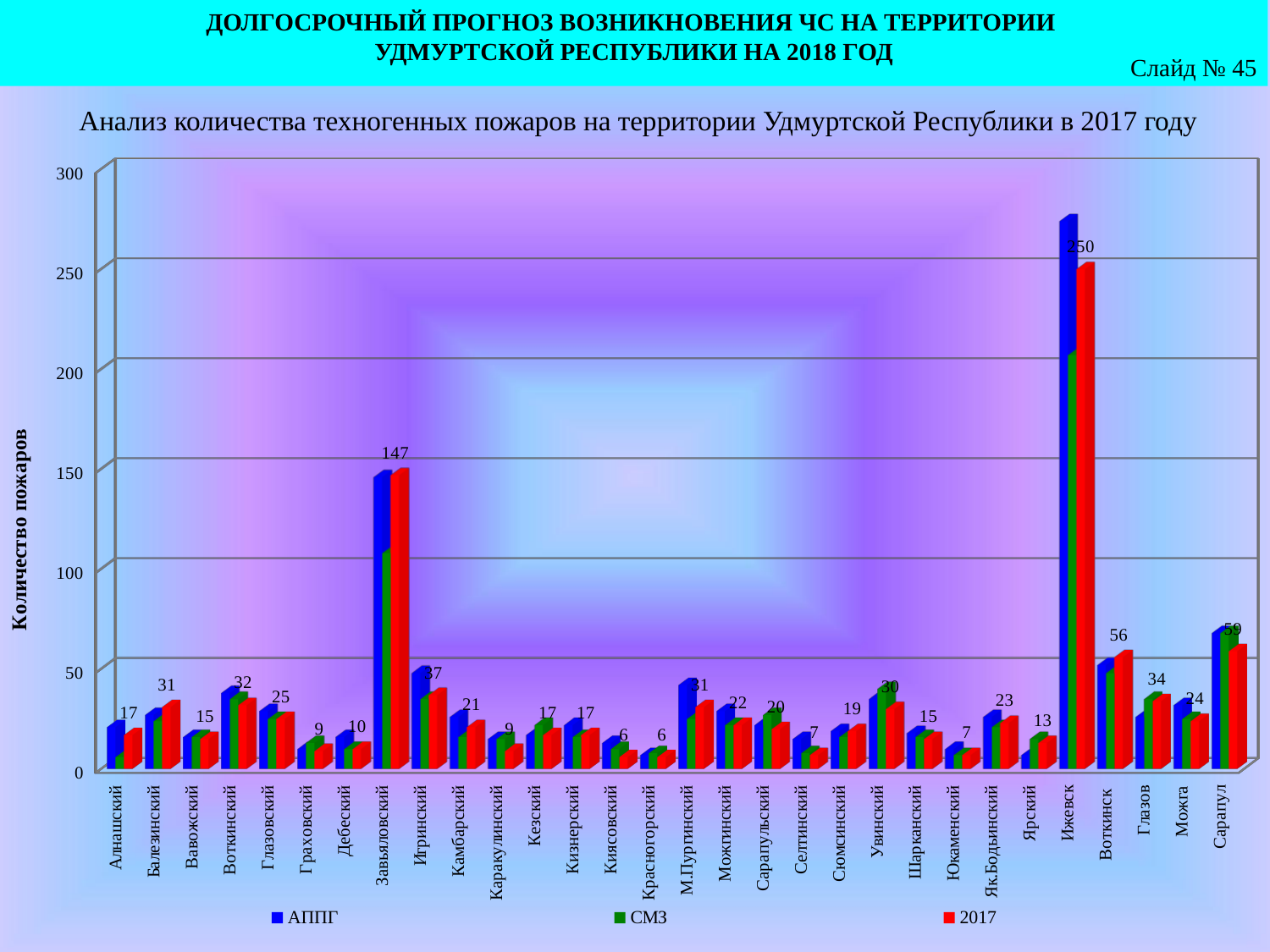
Which has the larger 2017 value, Сарапул or Воткинск? Сарапул How many categories are shown on the x axis? 30 Is the АППГ value for Ижевск greater or less than 250? greater What is the value of the 2017 series for Ижевск? 250 What is the value of the 2017 series for Игринский? 37 What is the difference between the 2017 values for Ижевск and Завьяловский? 103 What kind of chart is shown on the slide? bar chart Which category has the highest value in the 2017 series? Ижевск What is the value of the 2017 series for Воткинск? 56 What is the label of the y axis? Количество пожаров What is the value of the 2017 series for Завьяловский? 147 How many series does the legend list? 3